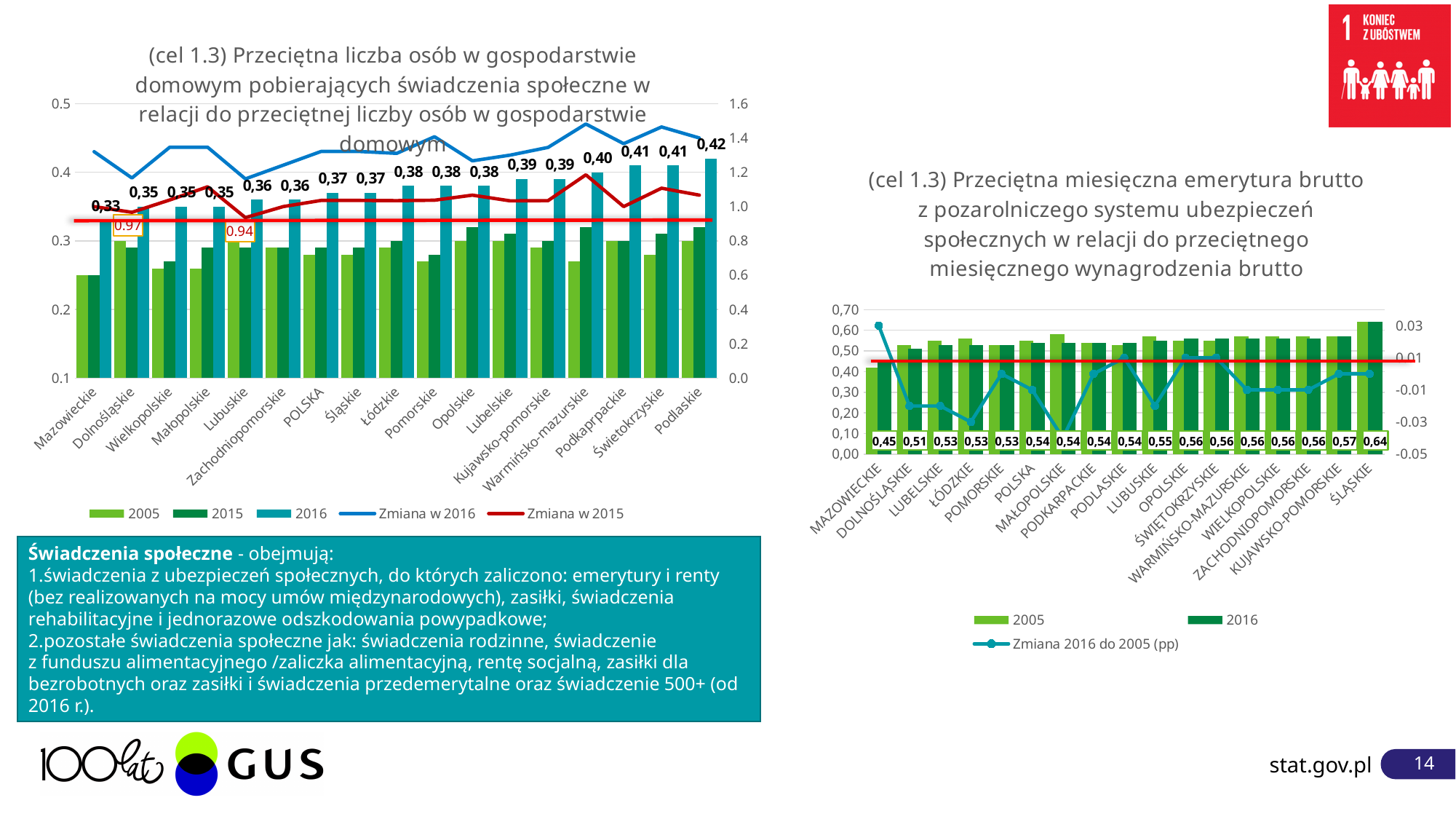
On the left chart, what value is labelled on the Zmiana w 2015 line at Lubuskie? 0,94 On the left chart, what is the difference between the labelled values for Podlaskie and Mazowieckie? 0,09 On the right chart, how many series does the legend list? 3 On the left chart, how many series does the legend list? 5 On the right chart, what is the difference between the labelled values for ŚLĄSKIE and MAZOWIECKIE? 0,19 On the left chart, what is the data label shown above the bars for Podlaskie? 0,42 On the right chart, do the labelled values rise or fall from left to right along the x axis? Rise On the right chart, what is the data label shown for POLSKA? 0,54 On the left chart, what kind of chart is it? Bar chart combined with line series On the right chart, which category has the highest labelled value? ŚLĄSKIE On the left chart, how many categories are shown on the x axis? 17 On the left chart, which category has the lowest labelled value? Mazowieckie